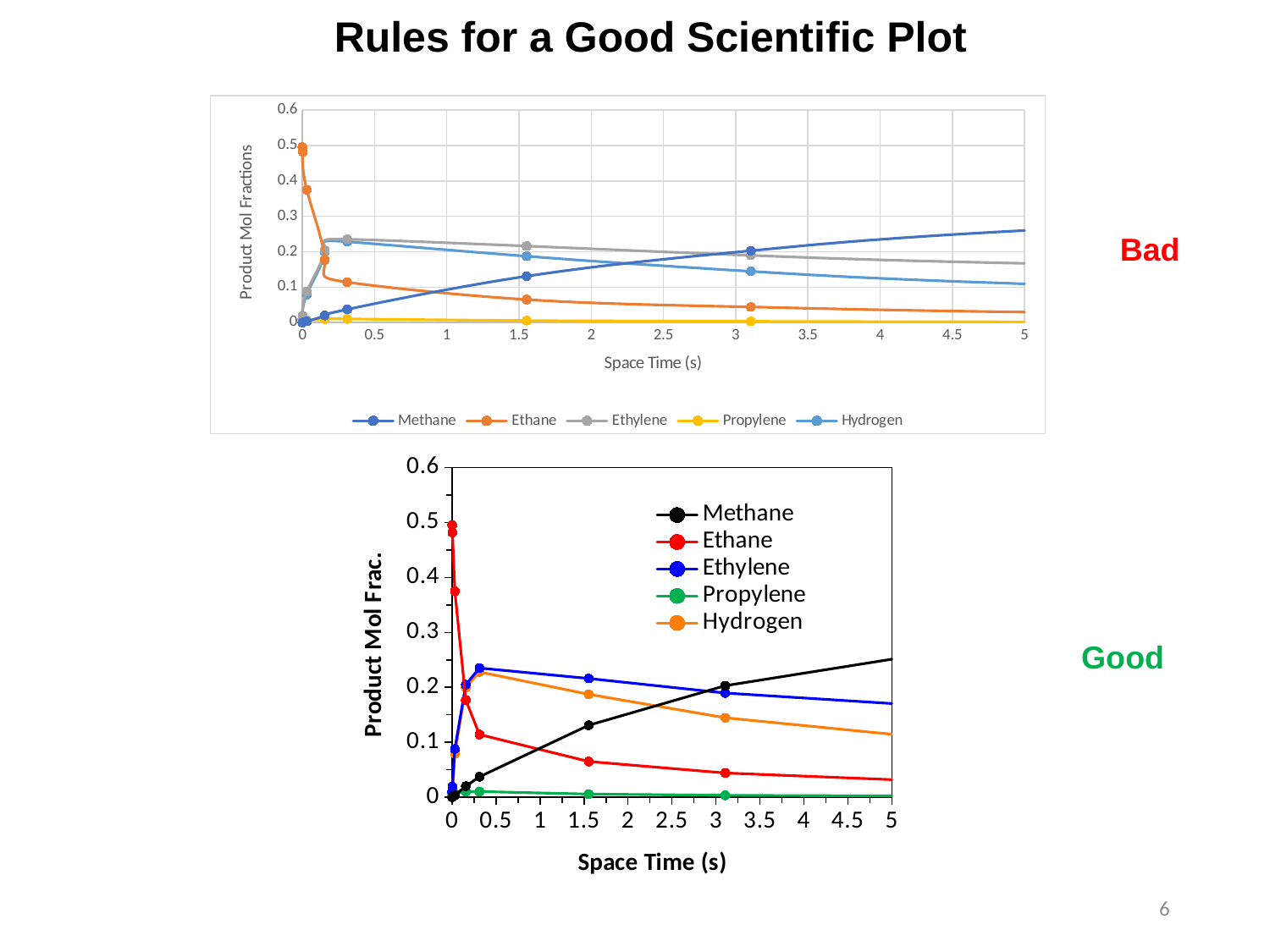
What kind of chart is the bottom chart labelled "Good"? line chart What is the x-axis title of the bottom chart labelled "Good"? Space Time (s) In the bottom chart labelled "Good", does the Methane series rise or fall as space time increases? rise How many series does the legend of the bottom chart labelled "Good" list? 5 In the bottom chart labelled "Good", is the Methane value at a space time of 5 s greater or less than 0.2? greater In the bottom chart labelled "Good", is the Ethane value at a space time of 5 s greater or less than 0.1? less In the bottom chart labelled "Good", which series has the highest value at a space time of 0 s? Ethane In the bottom chart labelled "Good", at a space time of 5 s, which is larger: Ethylene or Hydrogen? Ethylene In the bottom chart labelled "Good", which series has the highest value at a space time of 5 s? Methane In the top chart labelled "Bad", is the Ethylene value at a space time of 5 s greater or less than 0.2? less In the bottom chart labelled "Good", does the Ethane series rise or fall as space time increases from 0 to 5 s? fall How many series does the legend of the top chart labelled "Bad" list? 5